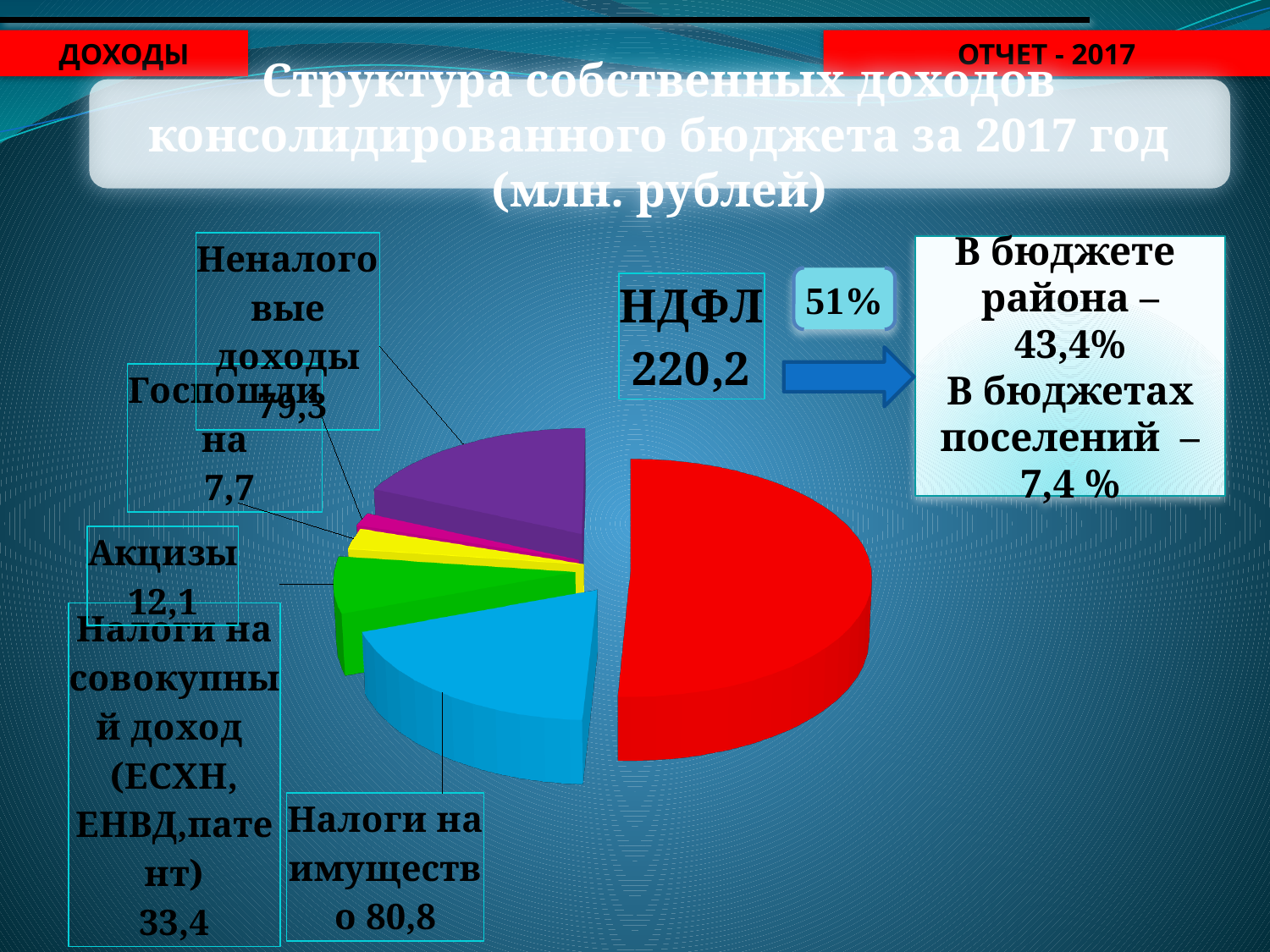
What kind of chart is shown on the slide? pie chart What is the value for Неналоговые доходы? 79,3 What is the value for НДФЛ? 220,2 What is the value for Госпошлина? 7,7 Which category has the largest slice of the pie? НДФЛ What share of the pie does НДФЛ represent, as labelled on the slide? 51% What unit is stated in the chart title? млн. рублей What is the difference between the values for НДФЛ and Налоги на имущество? 139,4 Which category has the smallest slice of the pie? Госпошлина What is the value for Акцизы? 12,1 Which is larger, the value for Акцизы or the value for Госпошлина? Акцизы What is the value for Налоги на имущество? 80,8